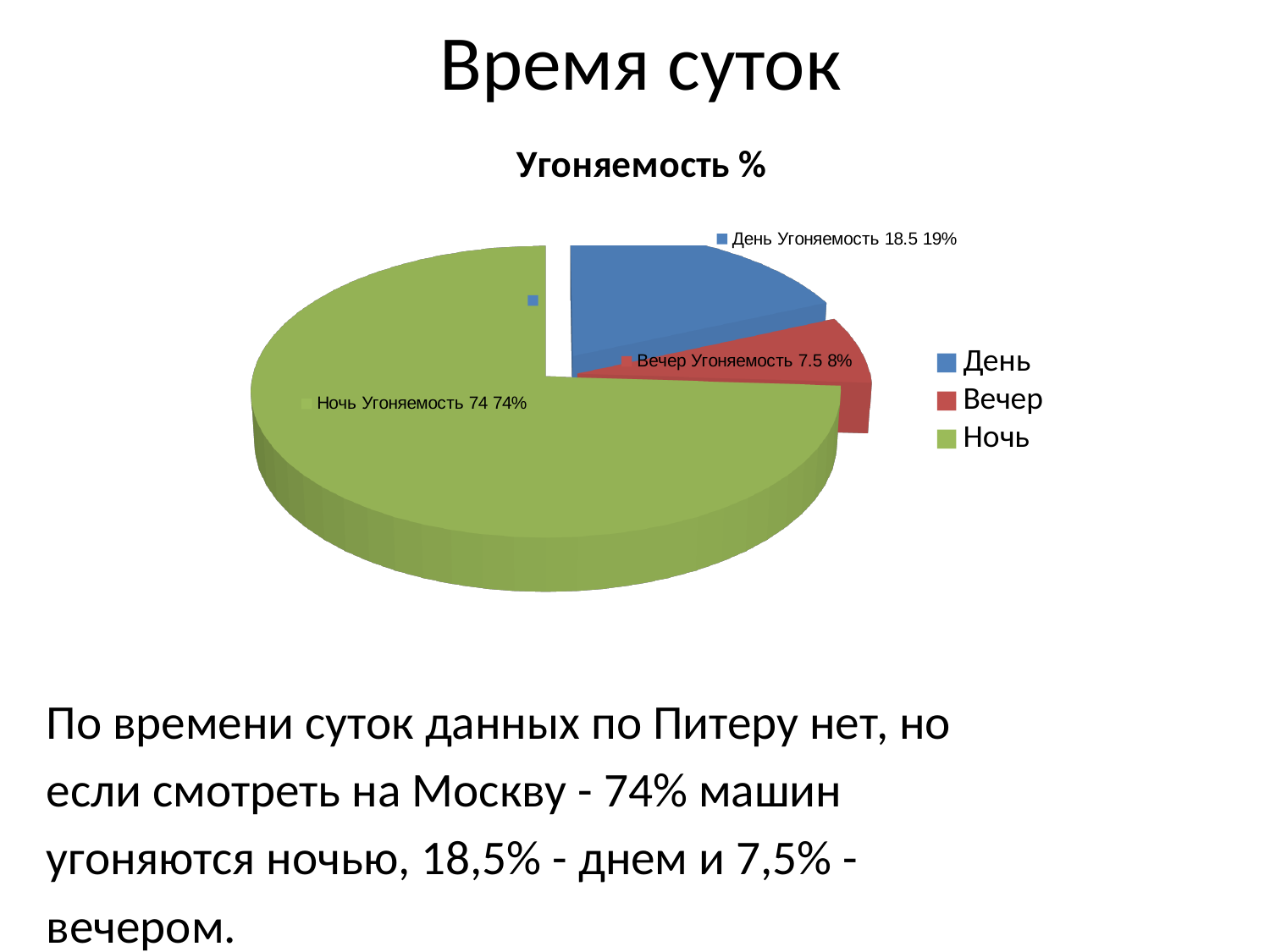
What is the value for Ночь (Night) in the pie chart? 74 How many categories does the pie chart have? 3 What percentage share of the pie does Ночь have? 74% Which category has the smallest slice of the pie? Вечер What type of chart is shown on the slide? Pie chart What percentage share of the pie does Вечер have? 8% What is the difference between the values for День and Вечер? 11 What is the value for Вечер (Evening) in the pie chart? 7.5 What percentage share of the pie does День have? 19% Which is larger, the value for День or the value for Вечер? День Which category has the largest slice of the pie? Ночь What is the value for День (Day) in the pie chart? 18.5